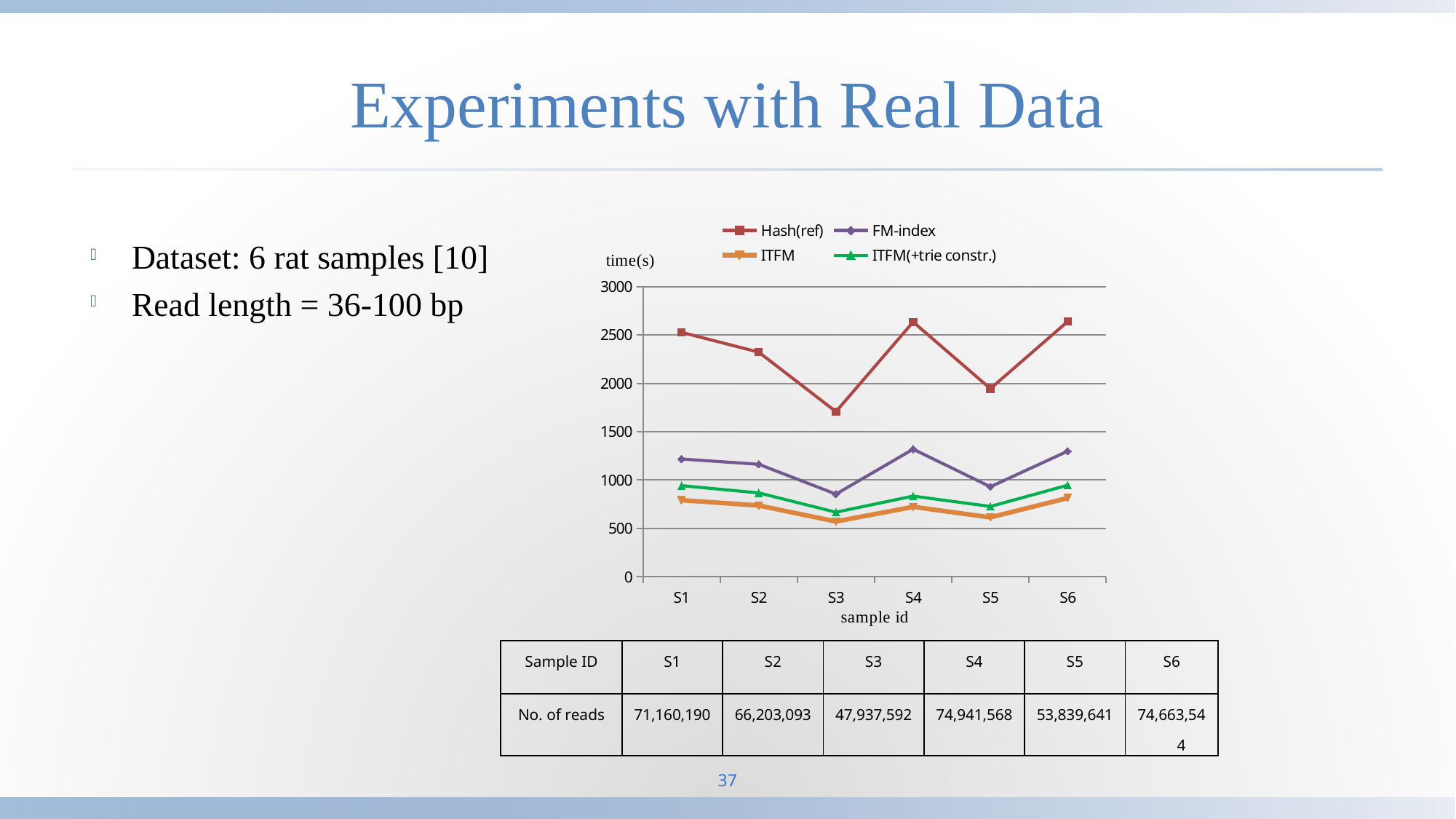
What kind of chart is shown on the slide? line chart Is the Hash(ref) value for S3 greater or less than 2000? less Is the ITFM value for S1 greater or less than 1000? less For which sample id is the Hash(ref) time lowest? S3 Is the FM-index value for S3 greater or less than 1000? less Which series has the highest times across all samples? Hash(ref) How many sample ids are plotted along the x axis of the chart? 6 Does the Hash(ref) line rise or fall from S1 to S3? fall What is the label on the y axis of the chart? time(s) At S1, which is larger: the Hash(ref) value or the FM-index value? Hash(ref) How many series does the chart legend list? 4